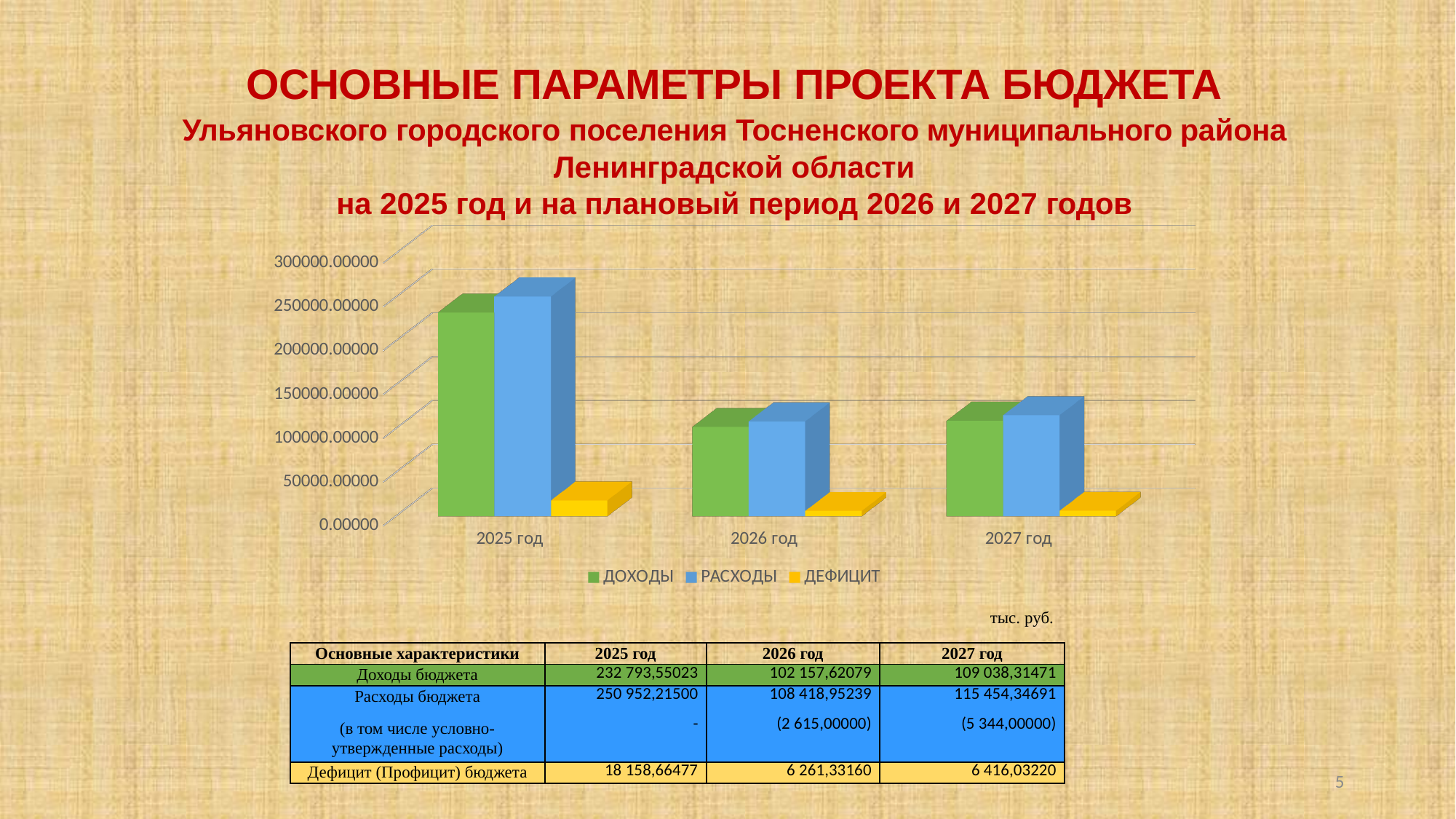
What colour represents the ДЕФИЦИТ series in the chart legend? yellow Which year has the highest ДОХОДЫ bar in the chart? 2025 год According to the table on the slide, what is the Дефицит (Профицит) бюджета value for 2027 год? 6 416,03220 How many series does the chart legend list? 3 What kind of chart is shown on the slide? bar chart Do the ДОХОДЫ bars rise or fall from 2025 год to 2026 год? fall Is the ДЕФИЦИТ value for 2025 год greater or less than 50000? less How many year categories are shown on the x axis of the chart? 3 Which year has the highest РАСХОДЫ bar in the chart? 2025 год Is the РАСХОДЫ value for 2026 год greater or less than 150000? less For 2025 год, which is larger in the chart: ДОХОДЫ or РАСХОДЫ? РАСХОДЫ Is the ДОХОДЫ value for 2025 год greater or less than 200000? greater